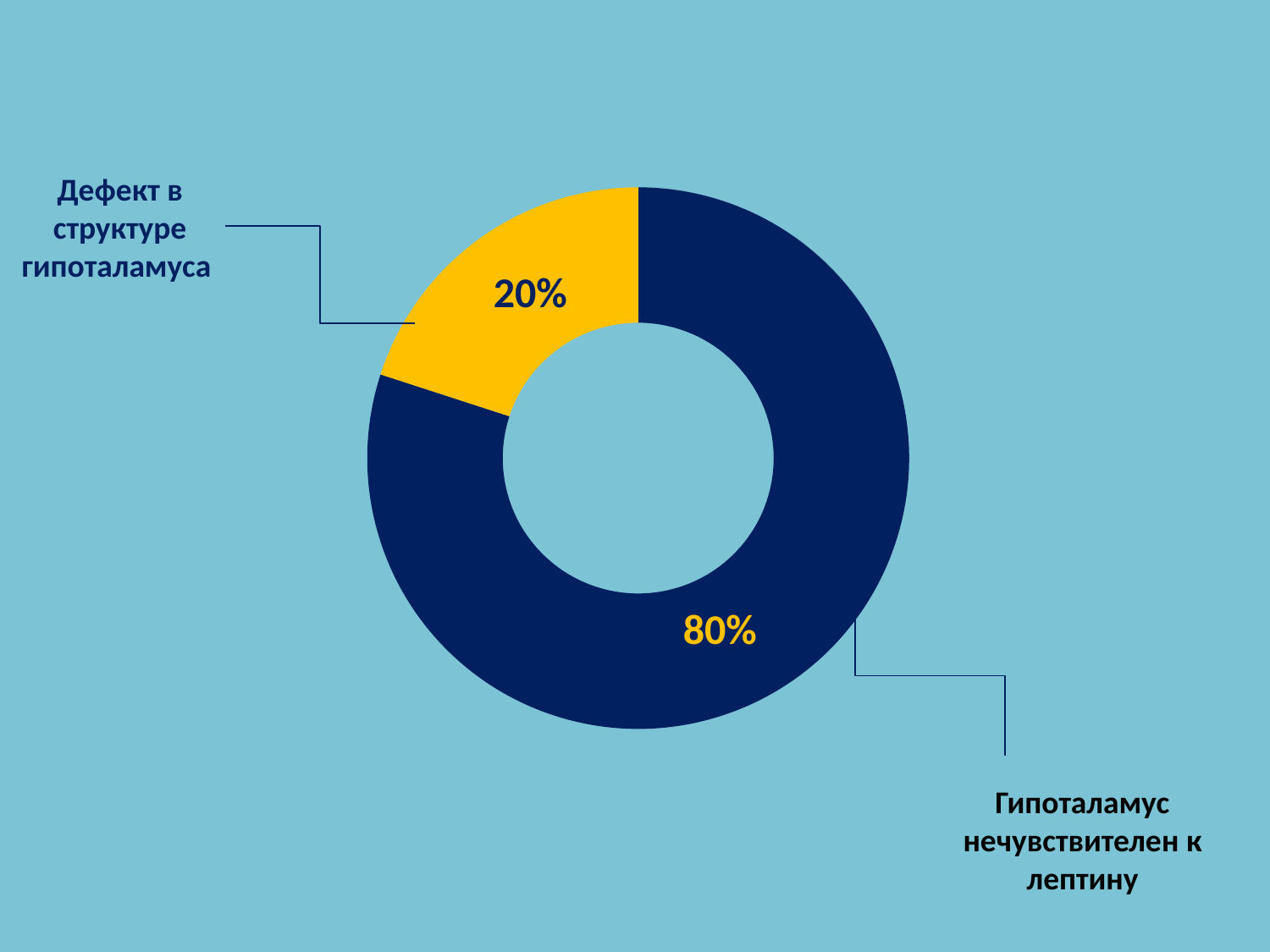
What is the difference in percentage points between the two slices? 60 percentage points What is the total of the two slice percentages shown? 100% Which category has the smallest share of the chart? Дефект в структуре гипоталамуса What kind of chart is shown on the slide? Doughnut (pie) chart What share of the chart is labelled "Дефект в структуре гипоталамуса"? 20% What share of the chart is labelled "Гипоталамус нечувствителен к лептину"? 80% What colour is the slice labelled 20%? Yellow Which is larger: the share for "Дефект в структуре гипоталамуса" or the share for "Гипоталамус нечувствителен к лептину"? Гипоталамус нечувствителен к лептину What colour is the slice labelled 80%? Dark navy blue Which category has the largest share of the chart? Гипоталамус нечувствителен к лептину How many categories (slices) does the chart have? 2